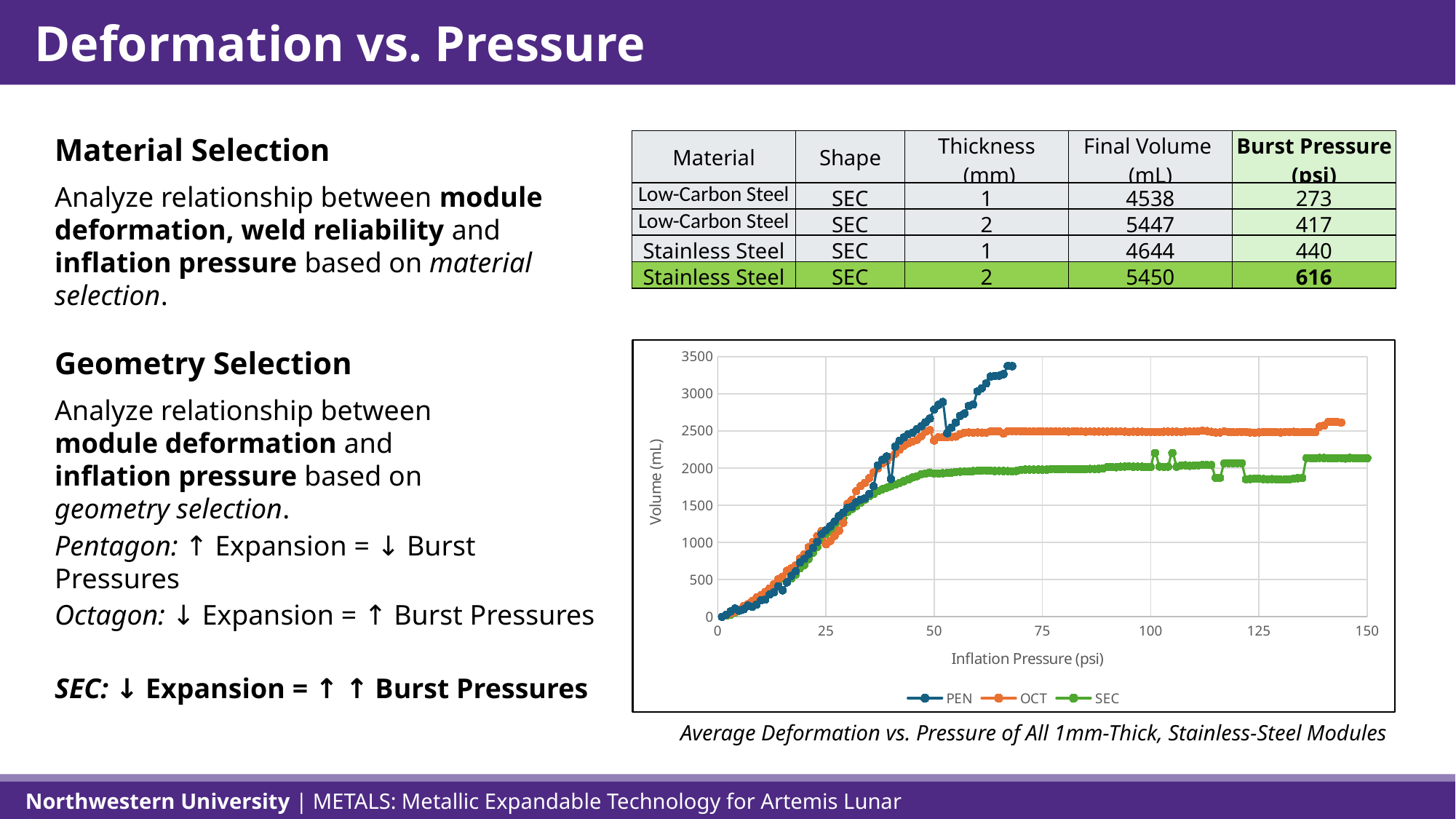
How many series does the chart legend list? 3 Is the highest volume reached by the PEN series greater or less than 3000 mL? greater What is the label of the chart's x axis? Inflation Pressure (psi) Is the volume of the SEC series at 100 psi greater or less than 1500 mL? greater Which series plateaus at the lowest volume on the chart? SEC What kind of chart is shown on the slide? line chart At an inflation pressure of 100 psi, which series has the larger volume, OCT or SEC? OCT Which series extends to the highest inflation pressure on the chart? SEC Is the volume of the OCT series at 100 psi greater or less than 3000 mL? less Which series reaches the highest volume on the chart? PEN What are the three series named in the chart legend? PEN, OCT, SEC Does the volume of the PEN series rise or fall as inflation pressure increases? rise